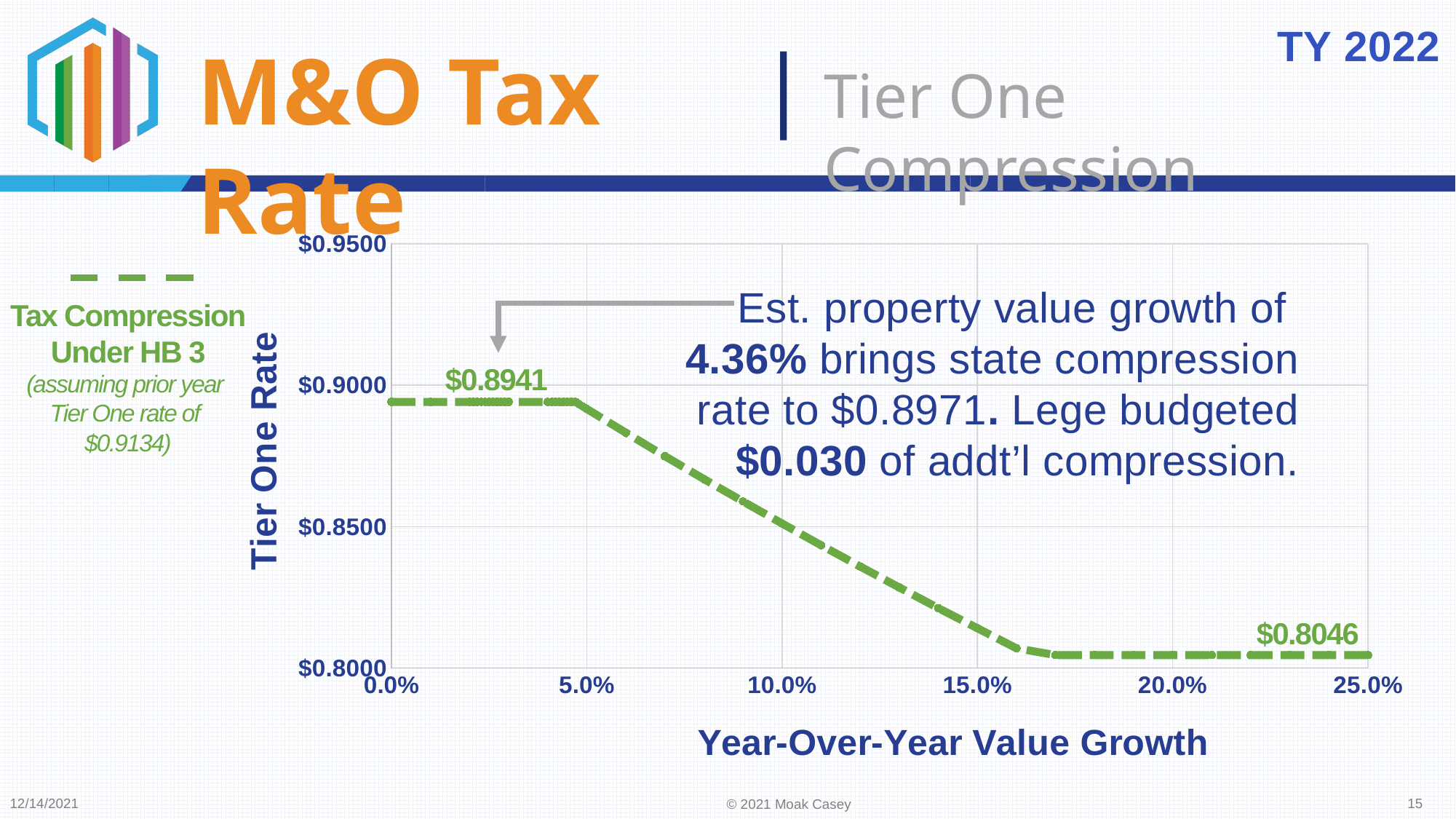
What is the difference between the Tier One Rate labelled at the start of the line ($0.8941) and the rate labelled at the end ($0.8046)? $0.0895 What is the highest Tier One Rate value labelled on the chart? $0.8941 What is the Tier One Rate at 0.0% year-over-year value growth? $0.8941 Does the Tier One Rate rise or fall as year-over-year value growth increases along the x axis? fall Is the Tier One Rate at 15.0% value growth greater or less than $0.8500? less What is the title of the chart's y axis? Tier One Rate What is the Tier One Rate at 25.0% year-over-year value growth? $0.8046 What is the title of the chart's x axis? Year-Over-Year Value Growth Which has the higher Tier One Rate: 0.0% value growth or 25.0% value growth? 0.0% How many series does the chart legend list? 1 What kind of chart is shown on the slide? line chart